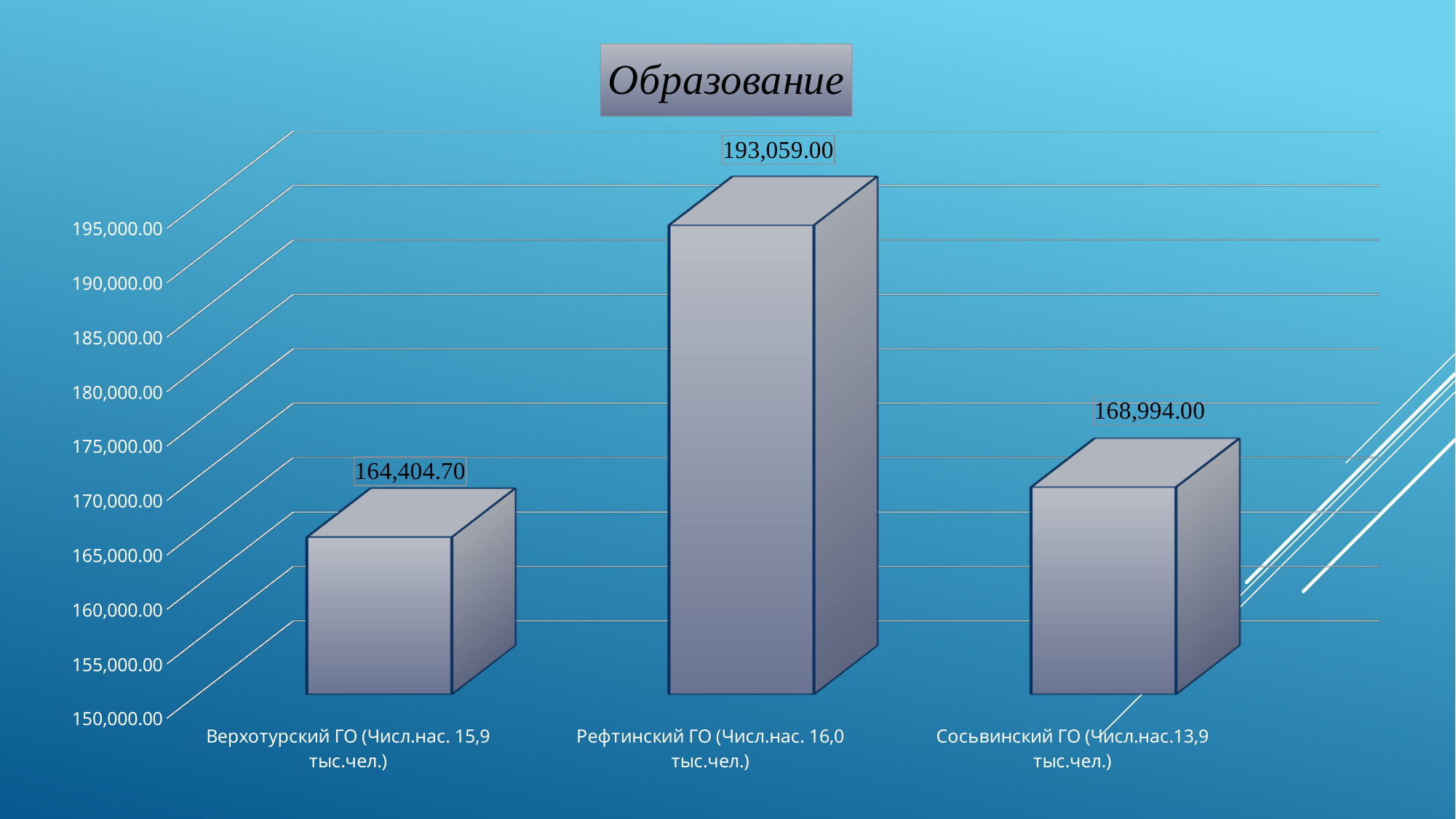
What is the value for Верхотурский ГО? 164,404.70 What is the title of the chart? Образование Which is larger, the value for Сосьвинский ГО or the value for Верхотурский ГО? Сосьвинский ГО What is the difference between the values for Сосьвинский ГО and Верхотурский ГО? 4,589.30 What is the difference between the values for Рефтинский ГО and Сосьвинский ГО? 24,065.00 What is the difference between the values for Рефтинский ГО and Верхотурский ГО? 28,654.30 What is the value for Сосьвинский ГО? 168,994.00 What is the value for Рефтинский ГО? 193,059.00 Which category has the lowest value? Верхотурский ГО Which category has the highest value? Рефтинский ГО Is the value for Рефтинский ГО greater or less than 190,000.00? greater How many categories are shown in the chart? 3